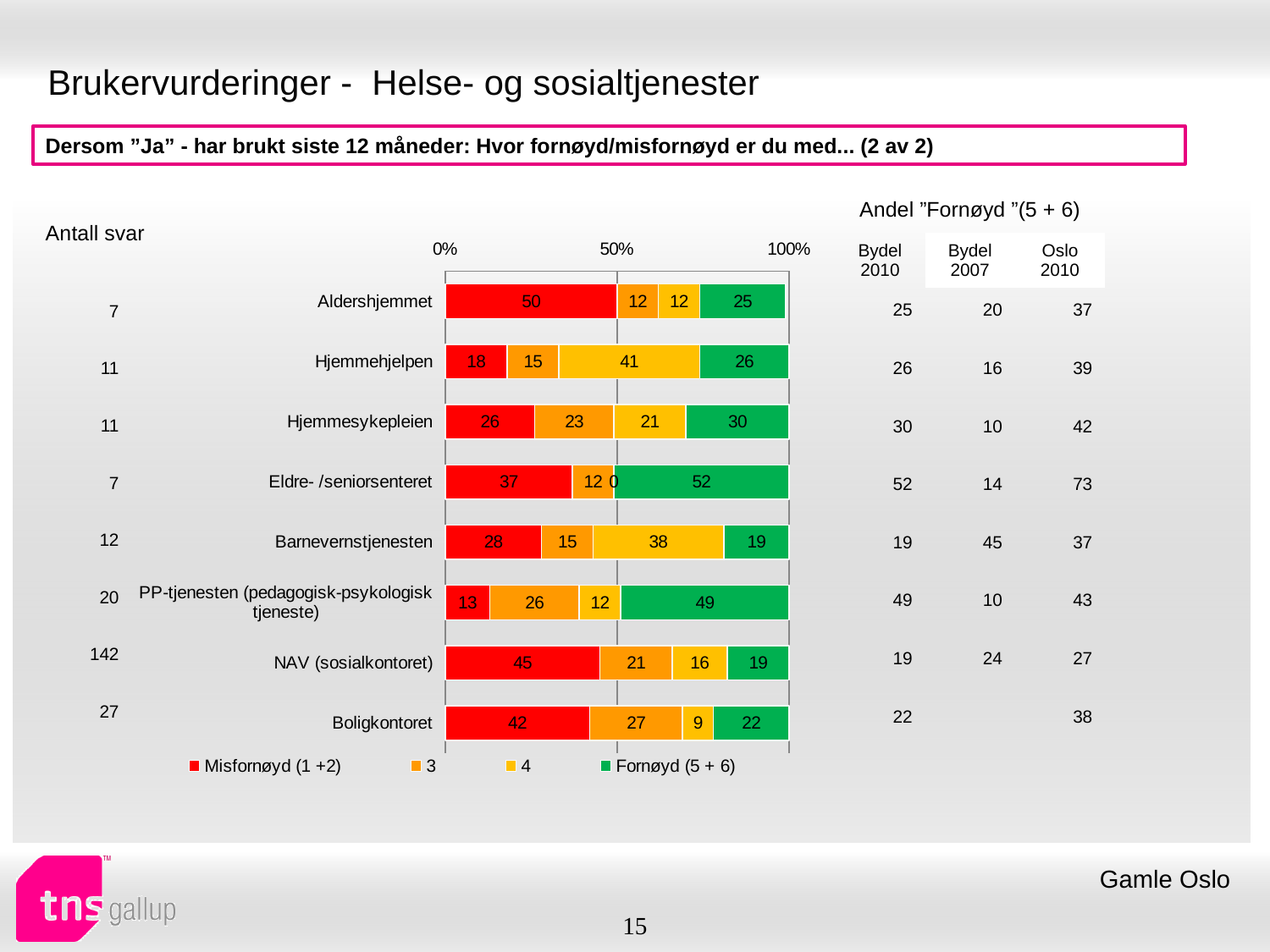
What is the value of series 3 for Boligkontoret? 27 Which category has the lowest Misfornøyd (1 +2) value? PP-tjenesten (pedagogisk-psykologisk tjeneste) What is the first entry in the chart legend? Misfornøyd (1 +2) What is the Misfornøyd (1 +2) value for Aldershjemmet? 50 What is the value of series 4 for Hjemmehjelpen? 41 How many series does the chart legend list? 4 What is the difference between the Misfornøyd (1 +2) values for NAV (sosialkontoret) and Boligkontoret? 3 What kind of chart is shown on the slide? bar chart Which category has the highest Fornøyd (5 + 6) value? Eldre- /seniorsenteret What is the Fornøyd (5 + 6) value for Eldre- /seniorsenteret? 52 Which has the larger Fornøyd (5 + 6) value, Hjemmesykepleien or Hjemmehjelpen? Hjemmesykepleien How many service categories are plotted in the chart? 8